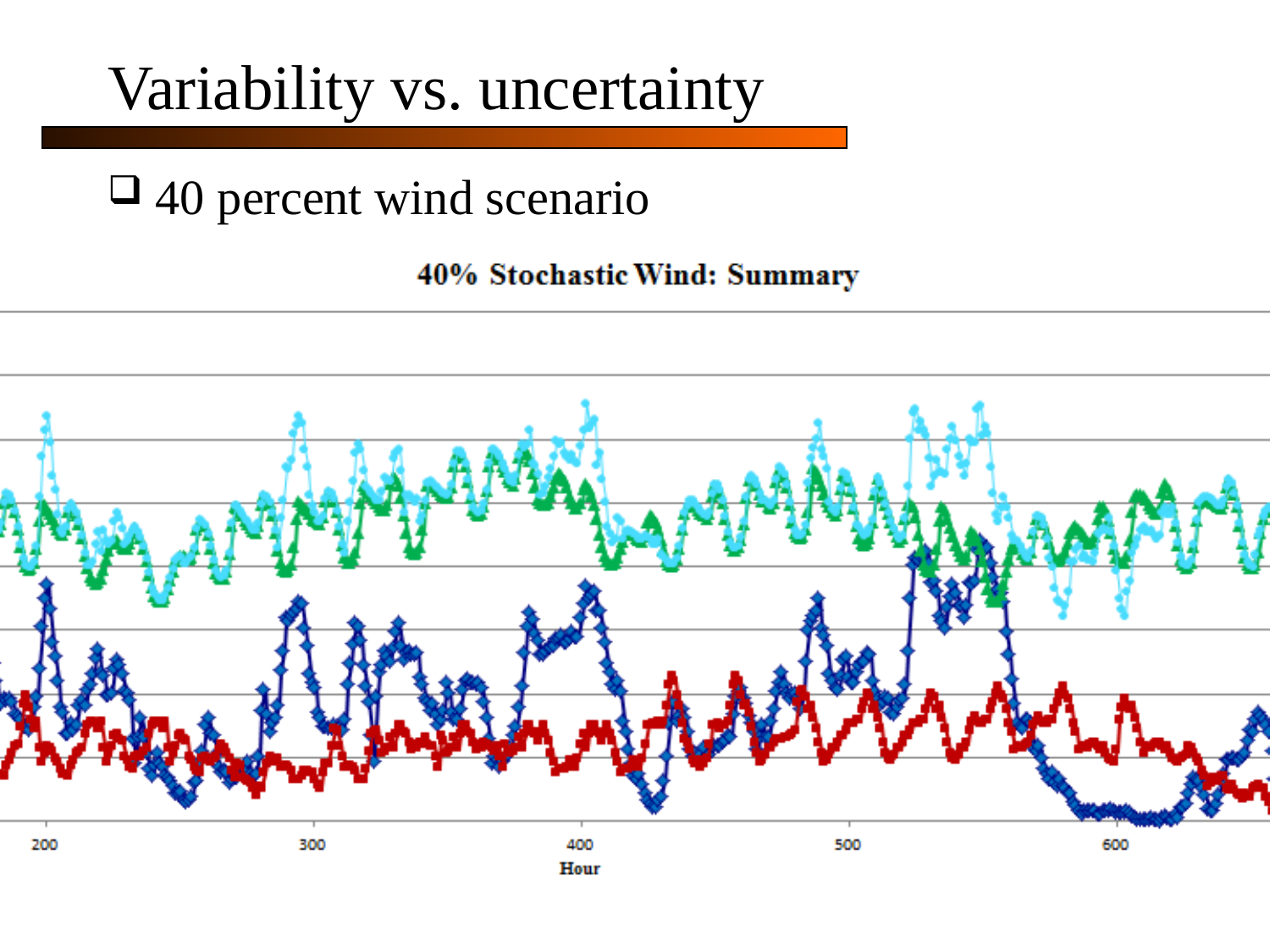
What is the largest tick value shown on the x axis of the chart? 600 What is the label of the x axis of the chart? Hour What kind of chart is shown on the slide? line chart What is the smallest tick value shown on the x axis of the chart? 200 Around hour 400, which line is higher, the cyan line or the dark blue line? the cyan line What is the title of the chart on the slide? 40% Stochastic Wind: Summary Which line on the chart stays lowest for most of the range, the green line or the red line? the red line How many differently coloured lines are plotted on the chart? 4 Around hour 600, which line is higher, the dark blue line or the red line? the red line